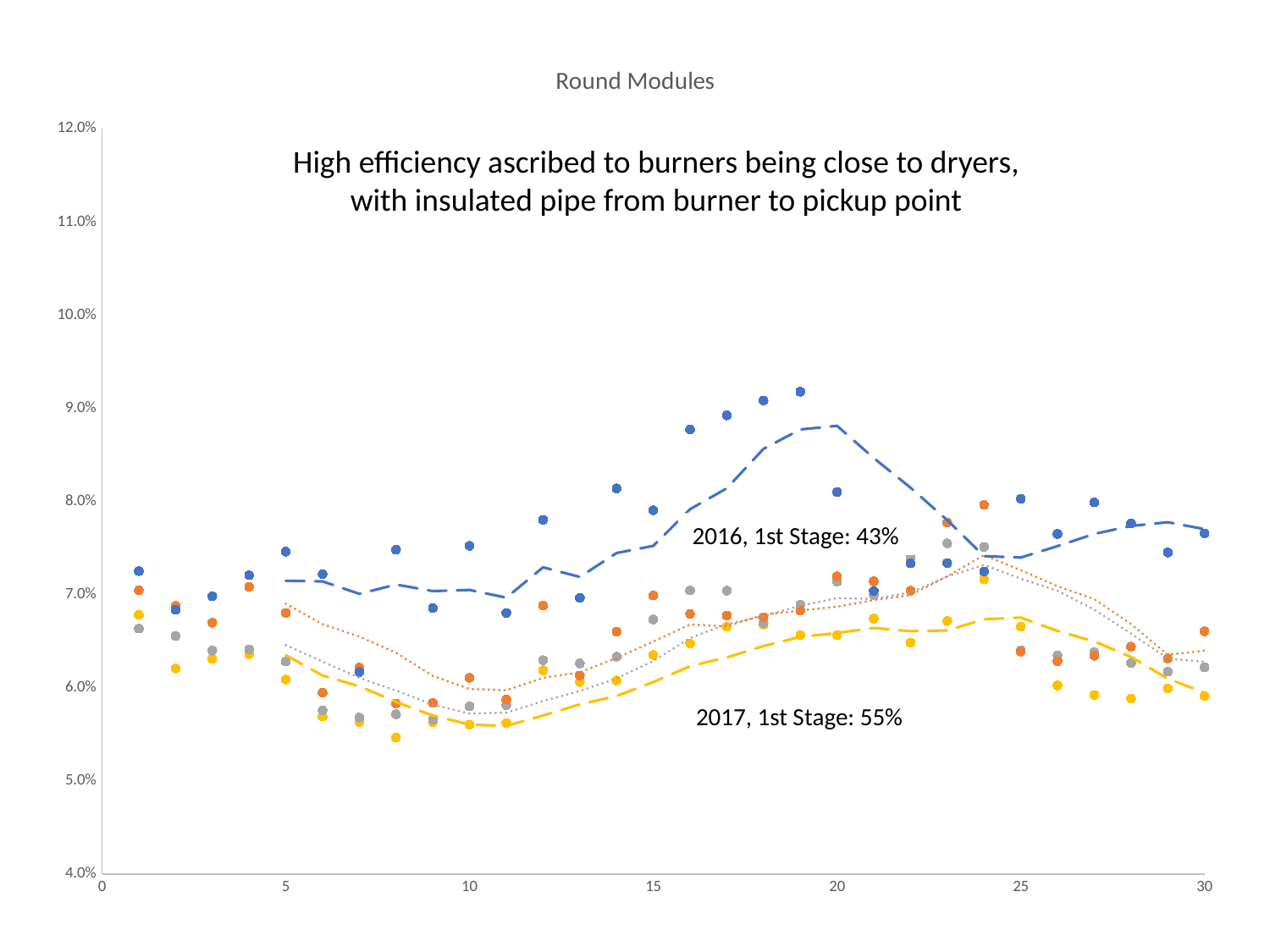
Is the value of the gray point at x = 1 greater or less than 7.0%? less Is the value of the blue point at x = 19 greater or less than 9.0%? greater Is the value of the blue point at x = 16 greater or less than 8.0%? greater Which is larger, the blue point at x = 19 or the blue point at x = 1? The blue point at x = 19 Which coloured series has the highest values on the chart? Blue What is the title of the chart? Round Modules What is the highest value shown on the y axis? 12.0% What kind of chart is shown on the slide? Scatter chart What percentage is given in the annotation for 2016, 1st Stage? 43% Do the blue points rise or fall between x = 11 and x = 19? Rise